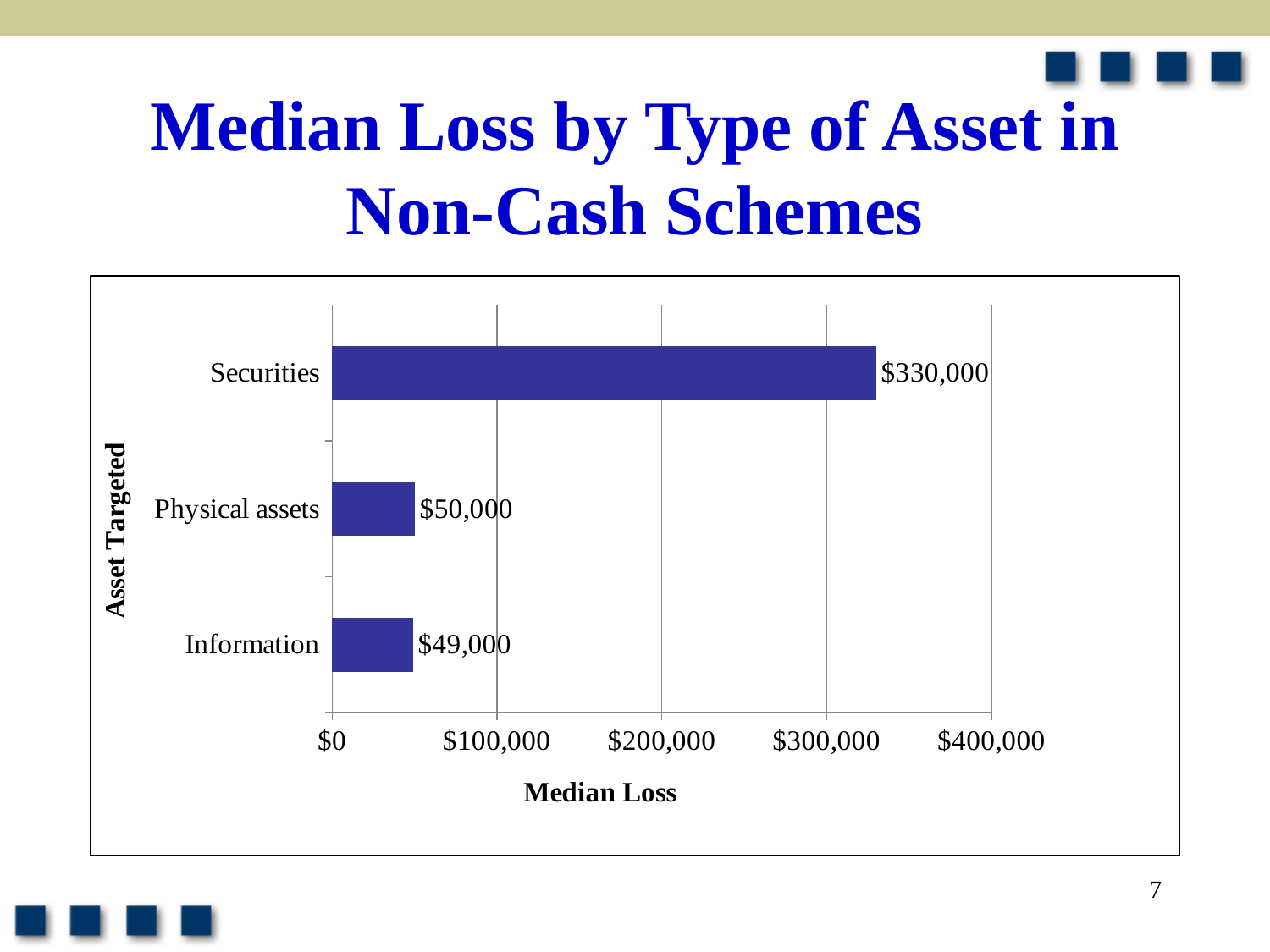
Which has a larger median loss, Securities or Information? Securities What is the difference between the median loss for Securities and for Physical assets? $280,000 Is the median loss for Securities greater or less than $300,000? greater What is the median loss for Securities? $330,000 What kind of chart is shown on the slide? Bar chart Which asset type has the lowest median loss? Information Which asset type has the highest median loss? Securities What is the difference between the median loss for Physical assets and for Information? $1,000 What is the median loss for Information? $49,000 What is the median loss for Physical assets? $50,000 What is the label of the horizontal axis? Median Loss How many asset types are shown in the chart? 3